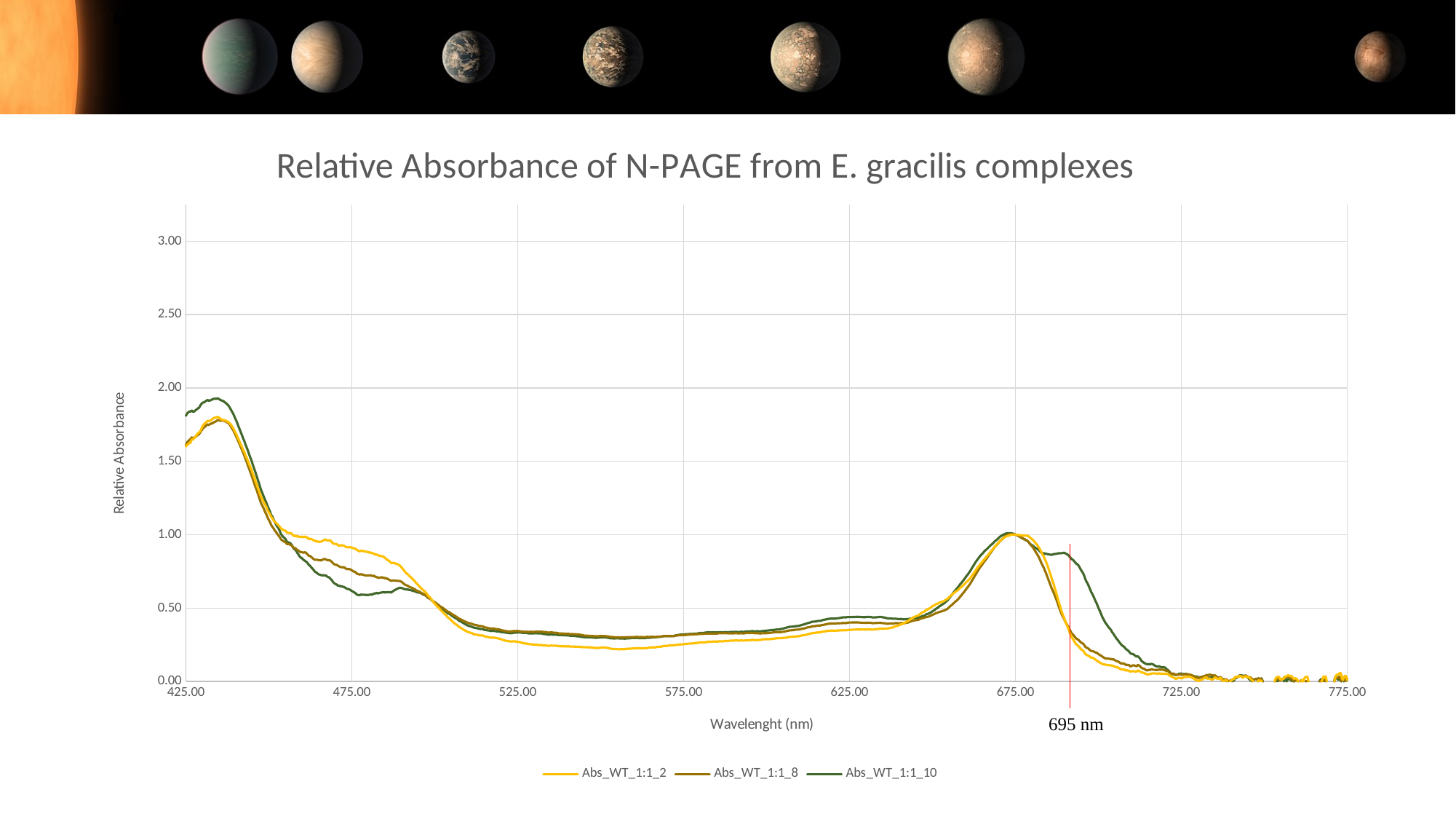
Which series has the lowest value at 475.00 nm? Abs_WT_1:1_10 Do the values rise or fall along the x axis between 425.00 nm and 525.00 nm? fall Is the value for Abs_WT_1:1_10 at 425.00 nm greater or less than 1.50? greater Is the peak value of the series near 675.00 nm greater or less than 1.50? less At 695 nm, which series has the larger value, Abs_WT_1:1_10 or Abs_WT_1:1_2? Abs_WT_1:1_10 Which series has the highest value at 475.00 nm? Abs_WT_1:1_2 Is the value for Abs_WT_1:1_2 at 475.00 nm greater or less than 0.50? greater What is the label of the x axis? Wavelenght (nm) What kind of chart is shown on the slide? line chart How many series does the legend list? 3 What is the title of the chart? Relative Absorbance of N-PAGE from E. gracilis complexes